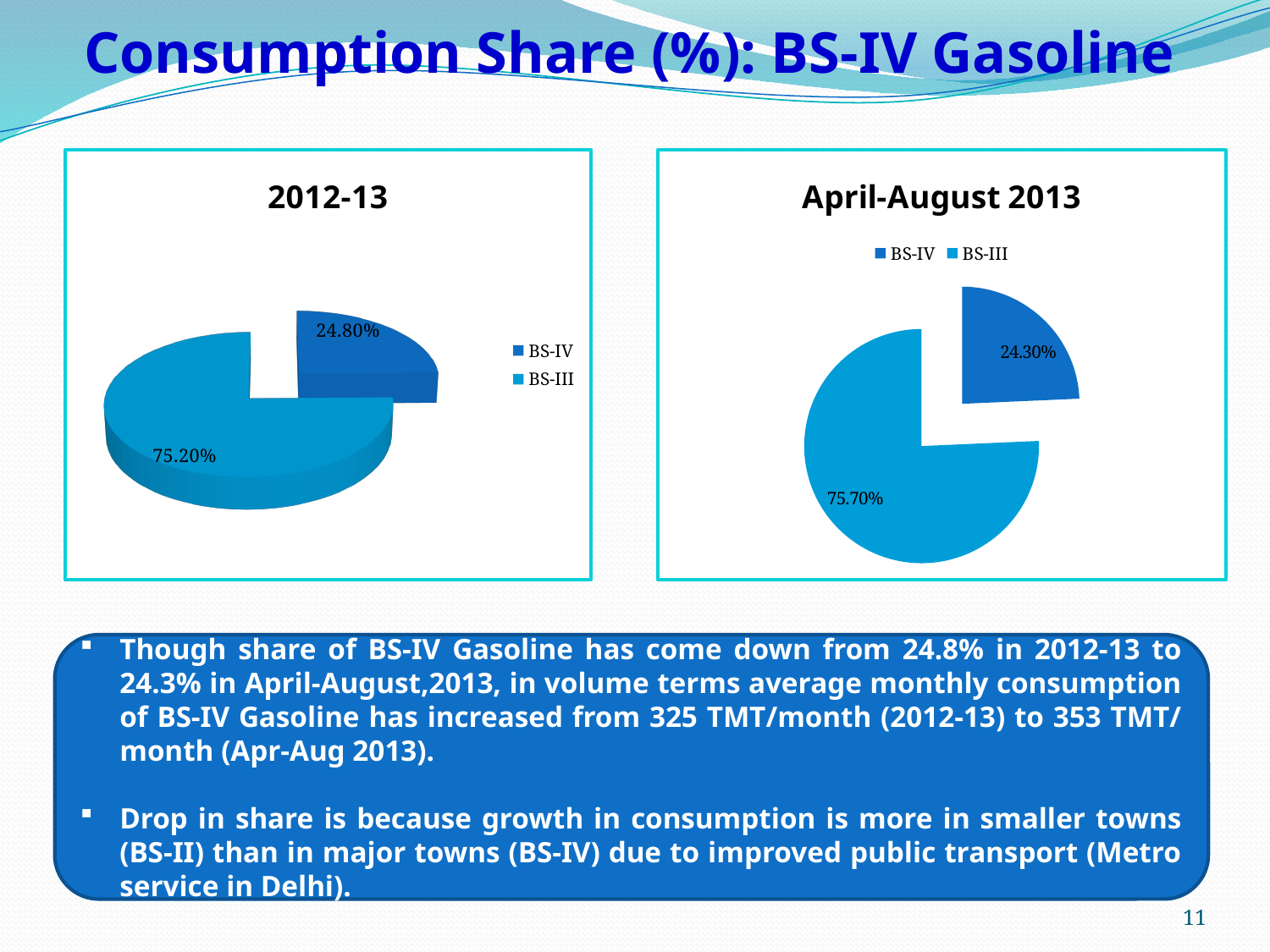
How many categories does the legend of the April-August 2013 chart list? 2 What is the title of the chart on the left? 2012-13 In the 2012-13 chart, what is the share for BS-IV? 24.80% In the April-August 2013 chart, what is the share for BS-III? 75.70% In the 2012-13 chart, which category has the largest slice? BS-III In the April-August 2013 chart, what is the share for BS-IV? 24.30% In the 2012-13 chart, what is the share for BS-III? 75.20% In the April-August 2013 chart, what is the difference between the BS-III and BS-IV shares? 51.40% What kind of chart is the 2012-13 chart? Pie chart In the 2012-13 chart, what is the difference between the BS-III and BS-IV shares? 50.40% In the April-August 2013 chart, which category has the smallest slice? BS-IV In the April-August 2013 chart, which is larger, BS-IV or BS-III? BS-III